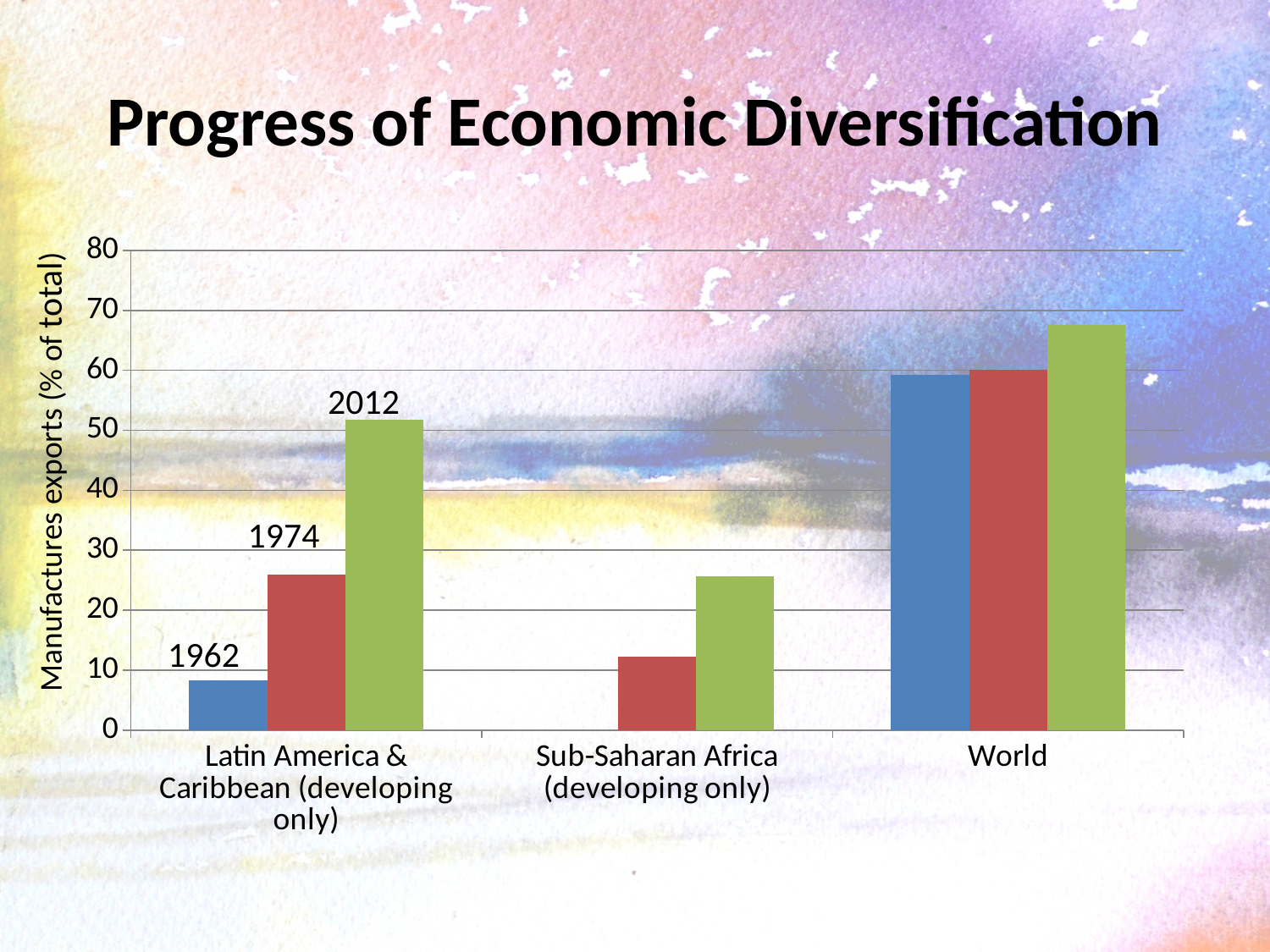
Which bar in the chart is the lowest overall? Latin America & Caribbean (developing only), 1962 Which category has the highest 2012 bar? World Is the 1962 value for Latin America & Caribbean (developing only) greater or less than 10? less Is the 2012 value for Latin America & Caribbean (developing only) greater or less than 40? greater What kind of chart is shown on the slide? bar chart Which is larger, the 2012 value for Latin America & Caribbean (developing only) or the 2012 value for Sub-Saharan Africa (developing only)? Latin America & Caribbean (developing only) How many categories are shown on the x axis of the chart? 3 Is the 2012 value for Sub-Saharan Africa (developing only) greater or less than 30? less What is the label on the vertical axis of the chart? Manufactures exports (% of total) For Latin America & Caribbean (developing only), do the values rise or fall from 1962 to 2012? rise How many years (series) are plotted for the Latin America & Caribbean (developing only) category? 3